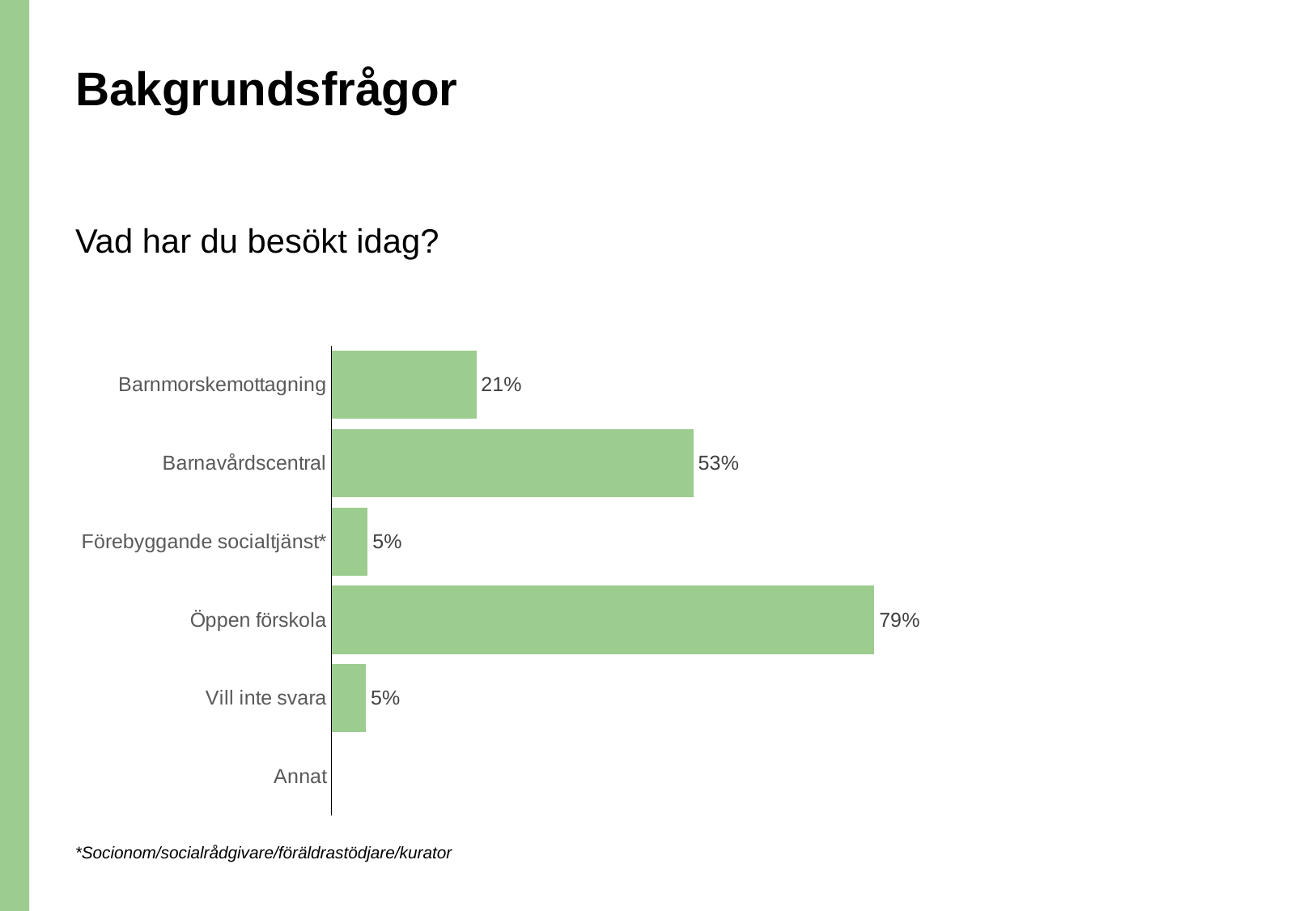
What is the value for Barnavårdscentral? 53% Which is larger, the value for Barnmorskemottagning or the value for Förebyggande socialtjänst*? Barnmorskemottagning What is the difference between the values for Öppen förskola and Barnavårdscentral? 26% What is the value for Barnmorskemottagning? 21% What colour are the bars in the chart? Green Which category has the highest value? Öppen förskola What is the value for Öppen förskola? 79% What is the difference between the values for Barnavårdscentral and Barnmorskemottagning? 32% What is the value for Vill inte svara? 5% How many categories are shown on the chart? 6 What kind of chart is shown on the slide? Bar chart What question does the chart answer, as written above it? Vad har du besökt idag?